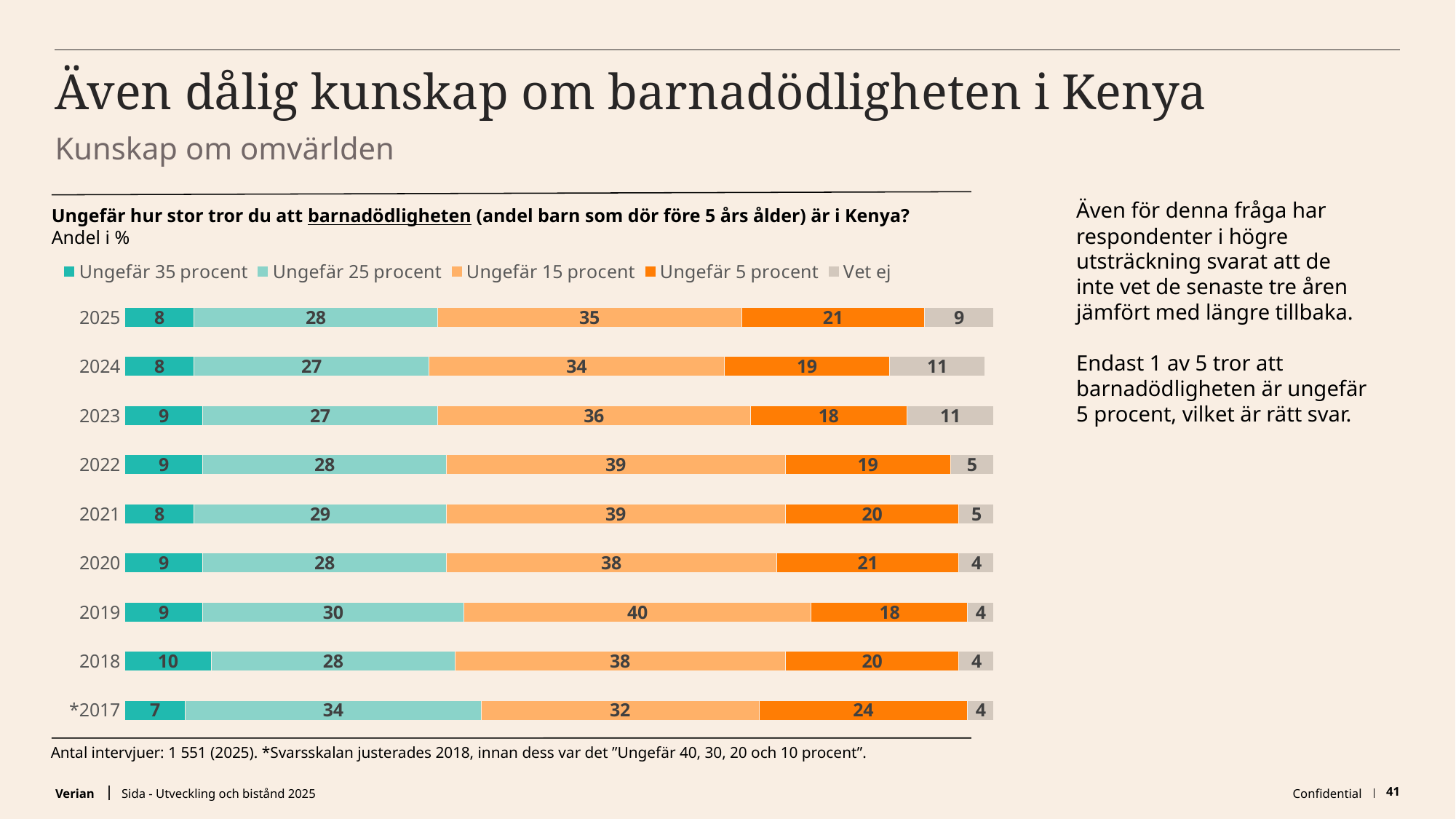
Which year has the highest value for "Ungefär 15 procent"? 2019 How many years are shown in the chart? 9 What is the value for "Ungefär 15 procent" in 2025? 35 Which year has the lowest value for "Ungefär 35 procent"? *2017 Which year has the larger value for "Ungefär 25 procent", 2019 or 2018? 2019 Which series is listed first in the legend? Ungefär 35 procent What is the total of the stacked bar for 2022? 100 What is the difference between the "Vet ej" values for 2025 and 2022? 4 What kind of chart is shown on the slide? Stacked bar chart What is the value for "Ungefär 5 procent" in *2017? 24 How many series does the legend list? 5 What is the value for "Vet ej" in 2024? 11